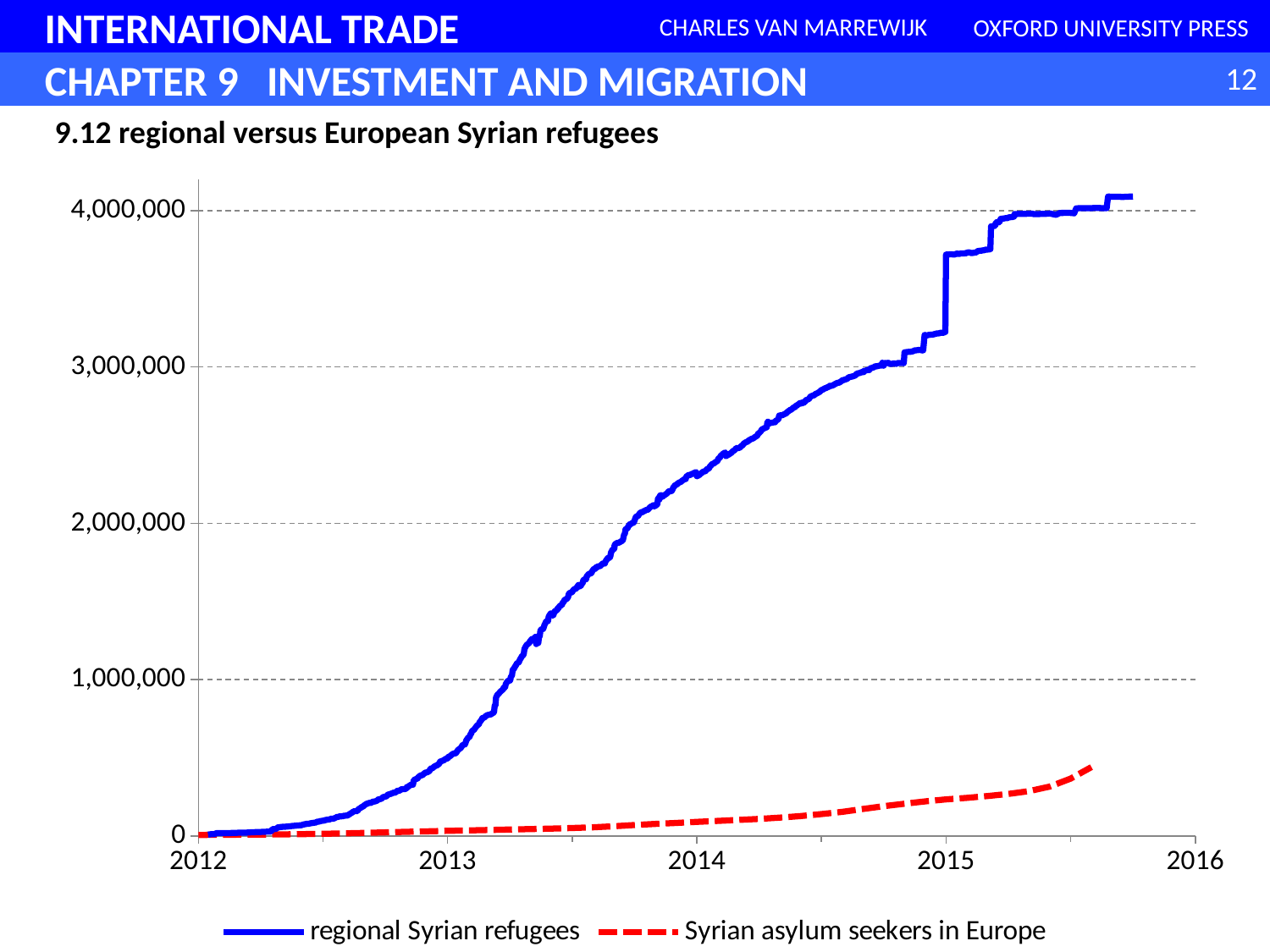
Which series reaches the highest value on the chart? regional Syrian refugees Which series is drawn as a red dashed line? Syrian asylum seekers in Europe What kind of chart is shown on the slide? line chart Do the values for Syrian asylum seekers in Europe rise or fall over the period shown? rise Is the value for regional Syrian refugees at the start of 2013 greater or less than 1,000,000? less Is the value for regional Syrian refugees at the start of 2015 greater or less than 3,000,000? greater Is the value for Syrian asylum seekers in Europe at the start of 2015 greater or less than 1,000,000? less Do the values for regional Syrian refugees rise or fall from 2012 to 2016? rise What is the title of the chart? 9.12 regional versus European Syrian refugees How many series does the legend list? 2 At the start of 2014, which series has the higher value: regional Syrian refugees or Syrian asylum seekers in Europe? regional Syrian refugees